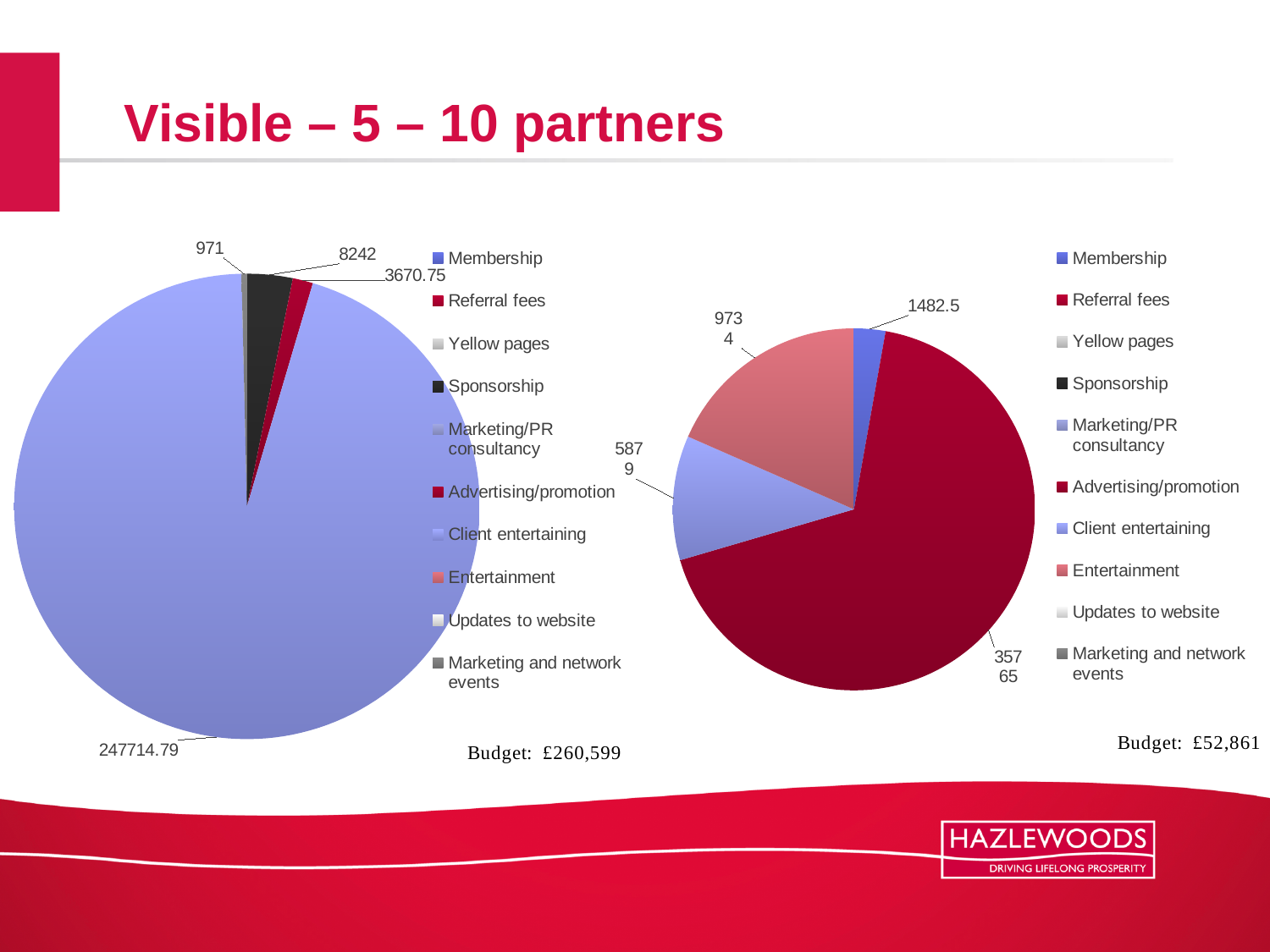
In the right pie chart, which is larger, Entertainment or Client entertaining? Entertainment In the left pie chart, what is the value shown for the largest slice? 247714.79 In the right pie chart, what is the difference between the Entertainment value and the Client entertaining value? 3855 In the right pie chart, which category has the largest slice? Advertising/promotion In the right pie chart, what is the value for Advertising/promotion? 35765 What budget figure is shown beneath the right pie chart? £52,861 In the right pie chart, what is the value for Membership? 1482.5 What type of charts are shown on the slide? Pie charts In the left pie chart, what is the value for Sponsorship? 8242